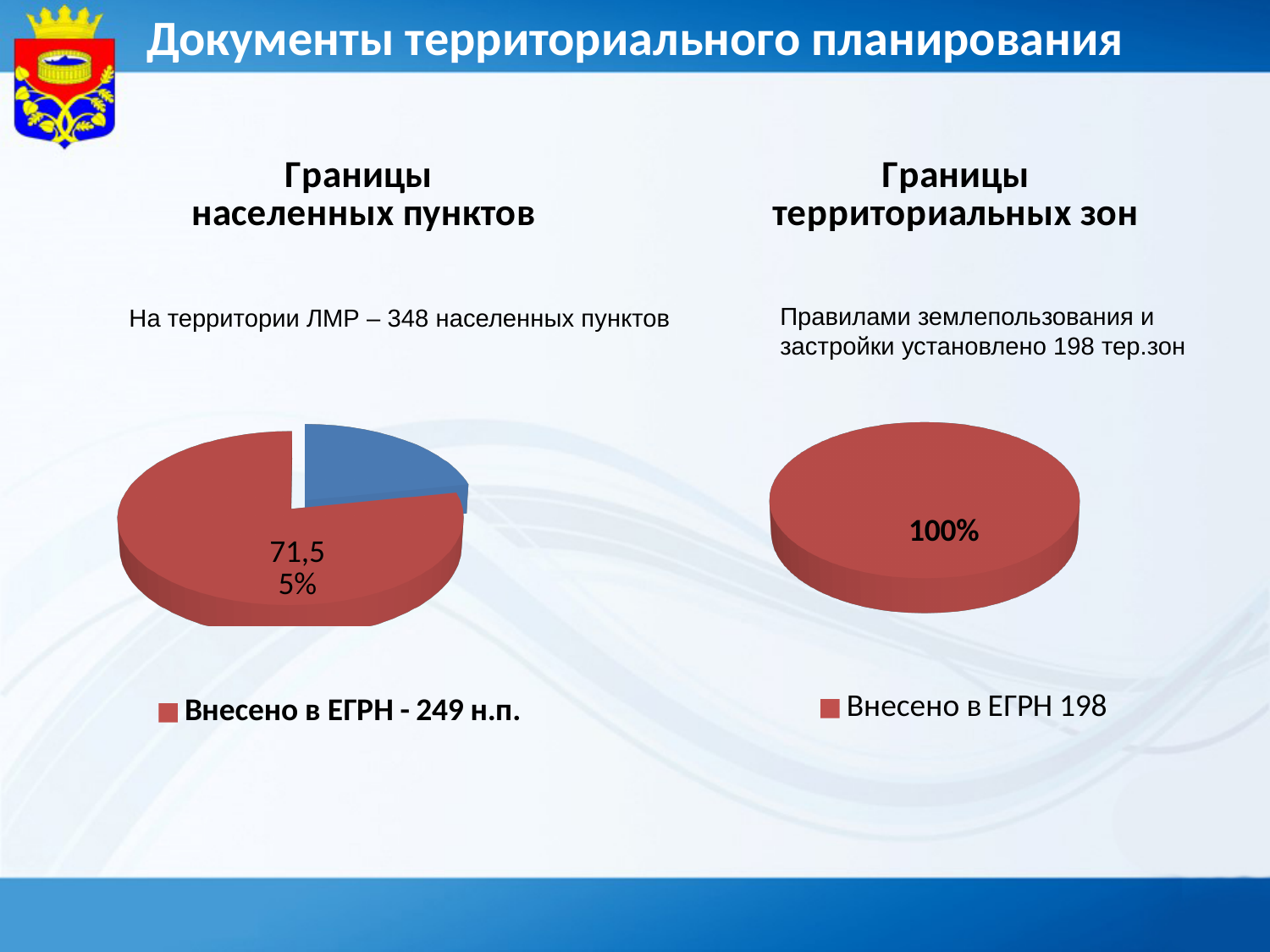
What is the legend entry of the left chart, 'Границы населенных пунктов'? Внесено в ЕГРН - 249 н.п. How many slices does the left chart, 'Границы населенных пунктов', have? 2 How many slices does the right chart, 'Границы территориальных зон', have? 1 In the right chart, 'Границы территориальных зон', what share of the pie does the 'Внесено в ЕГРН 198' slice take? 100% What kind of chart is the left chart, 'Границы населенных пунктов'? pie chart What is the legend entry of the right chart, 'Границы территориальных зон'? Внесено в ЕГРН 198 How many entries does the legend of the left chart, 'Границы населенных пунктов', list? 1 How many entries does the legend of the right chart, 'Границы территориальных зон', list? 1 In the right chart, 'Границы территориальных зон', what percentage is printed on the slice? 100% In the left chart, 'Границы населенных пунктов', which slice is larger, the red one or the blue one? the red one What kind of chart is the right chart, 'Границы территориальных зон'? pie chart In the left chart, 'Границы населенных пунктов', is the share of the red slice greater or less than 50%? greater